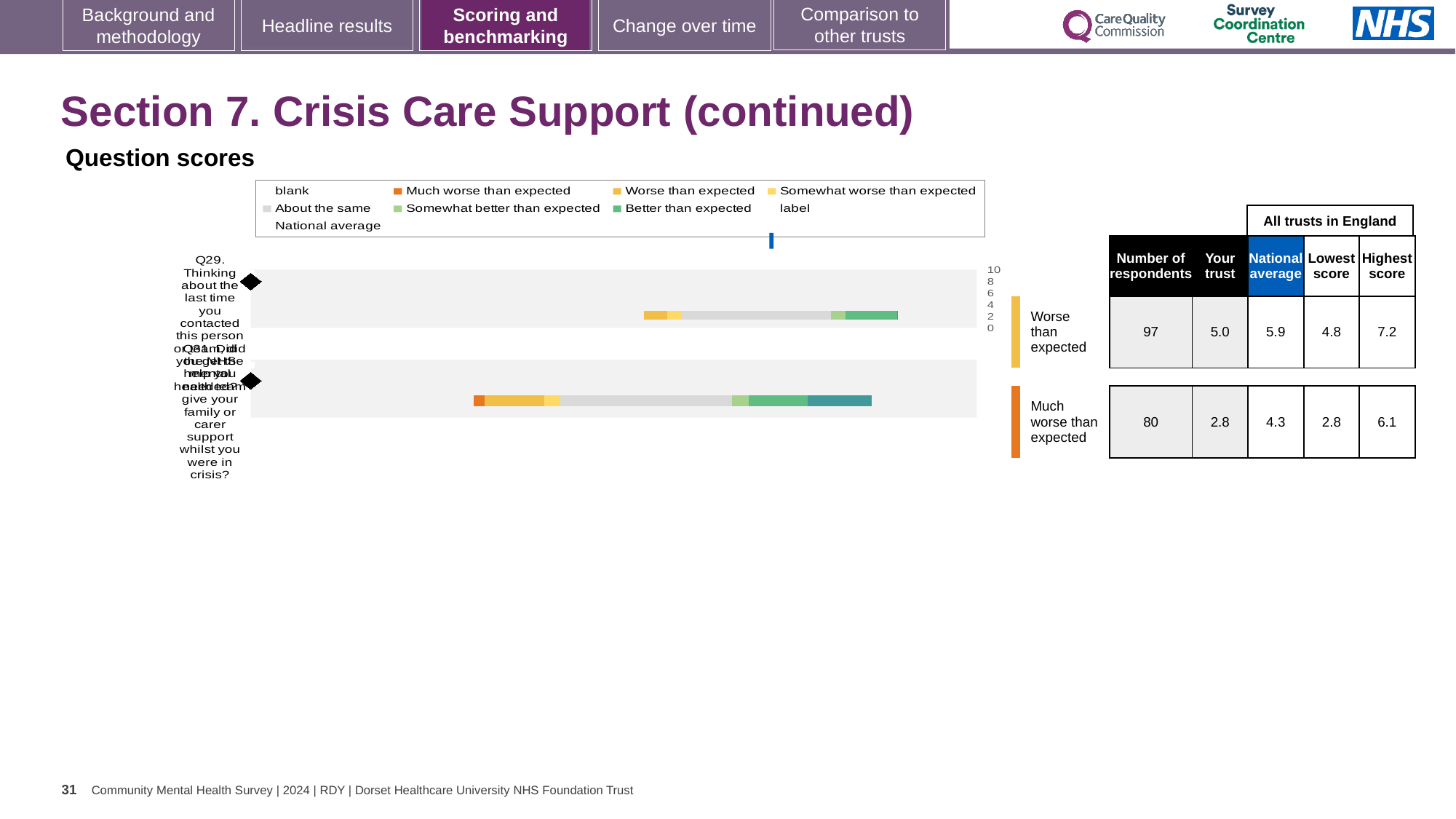
What is the highest score across all trusts in England for the row labelled 'Worse than expected'? 7.2 What colour does the legend use for 'Much worse than expected'? orange How much lower is the 'Your trust' score than the national average for the row labelled 'Worse than expected'? 0.9 In the table beside the chart, what is the 'Your trust' score for the row labelled 'Worse than expected'? 5.0 In the table beside the chart, what is the 'Your trust' score for the row labelled 'Much worse than expected'? 2.8 What is the number of respondents for the row labelled 'Worse than expected'? 97 How many questions are plotted as bars in the question scores chart? 2 What is the difference between the highest and lowest scores for the row labelled 'Much worse than expected'? 3.3 What is the national average for the row labelled 'Much worse than expected'? 4.3 Which row has the larger 'Your trust' score: 'Worse than expected' or 'Much worse than expected'? Worse than expected What kind of chart is used to show the question scores on this slide? bar chart What is the lowest score across all trusts in England for the row labelled 'Much worse than expected'? 2.8